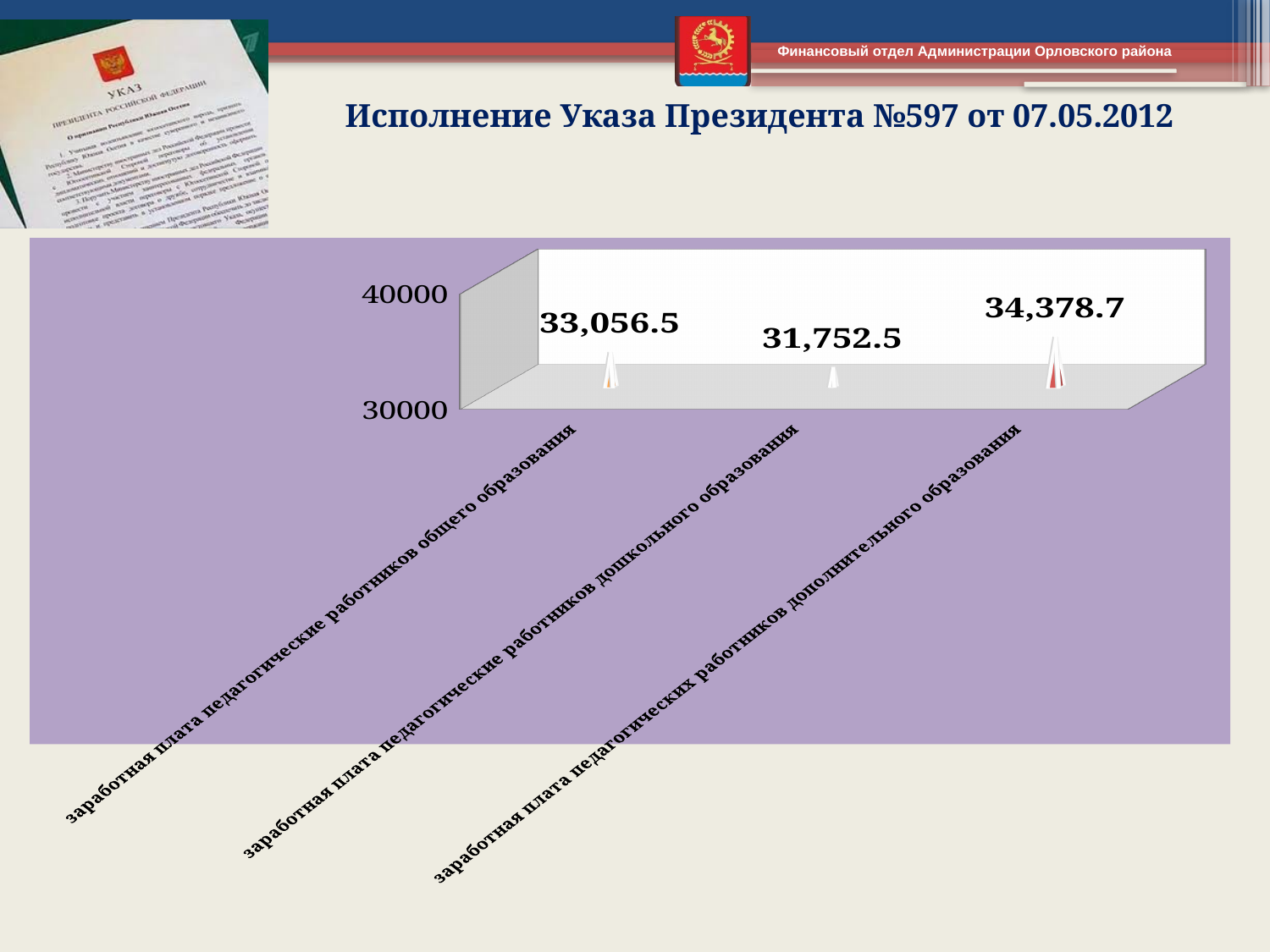
Which category has the highest value? заработная плата педагогических работников дополнительного образования What is the value shown for заработная плата педагогические работников общего образования? 33,056.5 What is the difference between the values for дополнительного образования and общего образования? 1,322.2 Which category has the lowest value? заработная плата педагогические работников дошкольного образования How many categories are shown in the chart? 3 What is the value shown for заработная плата педагогических работников дополнительного образования? 34,378.7 What is the value shown for заработная плата педагогические работников дошкольного образования? 31,752.5 What is the title of the slide containing the chart? Исполнение Указа Президента №597 от 07.05.2012 What is the difference between the values for общего образования and дошкольного образования? 1,304.0 Is the value for дошкольного образования greater or less than 30000? greater Is the value for дополнительного образования greater or less than 40000? less Which is larger: the value for общего образования or the value for дошкольного образования? общего образования